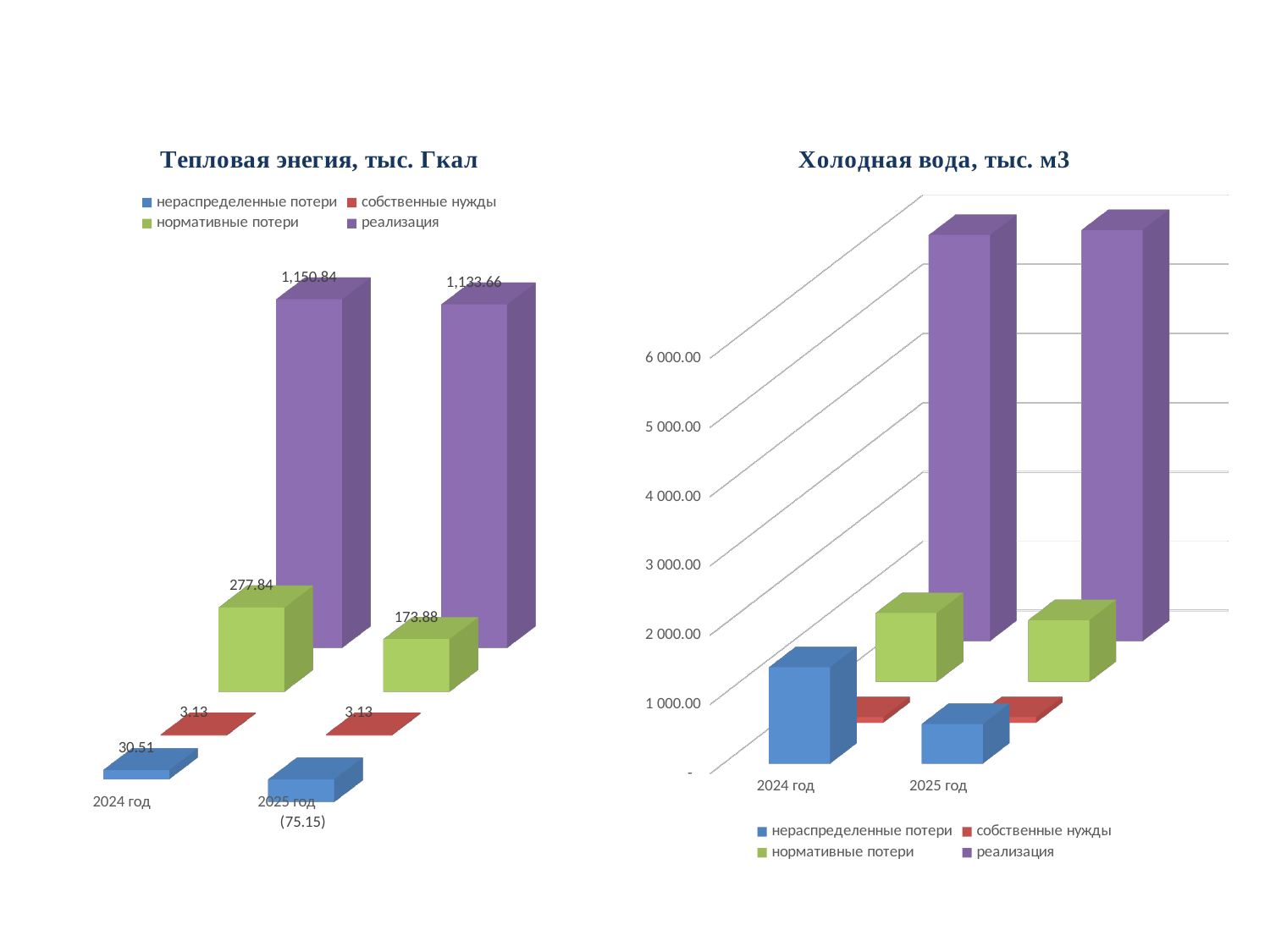
On the 'Тепловая энегия, тыс. Гкал' chart, which year has the higher value of нормативные потери? 2024 год On the 'Тепловая энегия, тыс. Гкал' chart, what is the difference between нормативные потери in 2024 год and 2025 год? 103.96 On the 'Тепловая энегия, тыс. Гкал' chart, which series has the highest value in 2024 год? реализация On the 'Тепловая энегия, тыс. Гкал' chart, what is the value of нормативные потери for 2025 год? 173.88 On the 'Тепловая энегия, тыс. Гкал' chart, what is the value of реализация for 2024 год? 1,150.84 On the 'Холодная вода, тыс. м3' chart, which year has the higher value of нераспределенные потери? 2024 год What type of chart is the 'Холодная вода, тыс. м3' chart? bar chart On the 'Тепловая энегия, тыс. Гкал' chart, what is the value of собственные нужды for 2024 год? 3.13 On the 'Тепловая энегия, тыс. Гкал' chart, what is the difference between реализация in 2024 год and 2025 год? 17.18 How many series does the legend of the 'Холодная вода, тыс. м3' chart list? 4 On the 'Тепловая энегия, тыс. Гкал' chart, what is the value of нераспределенные потери for 2025 год? (75.15)